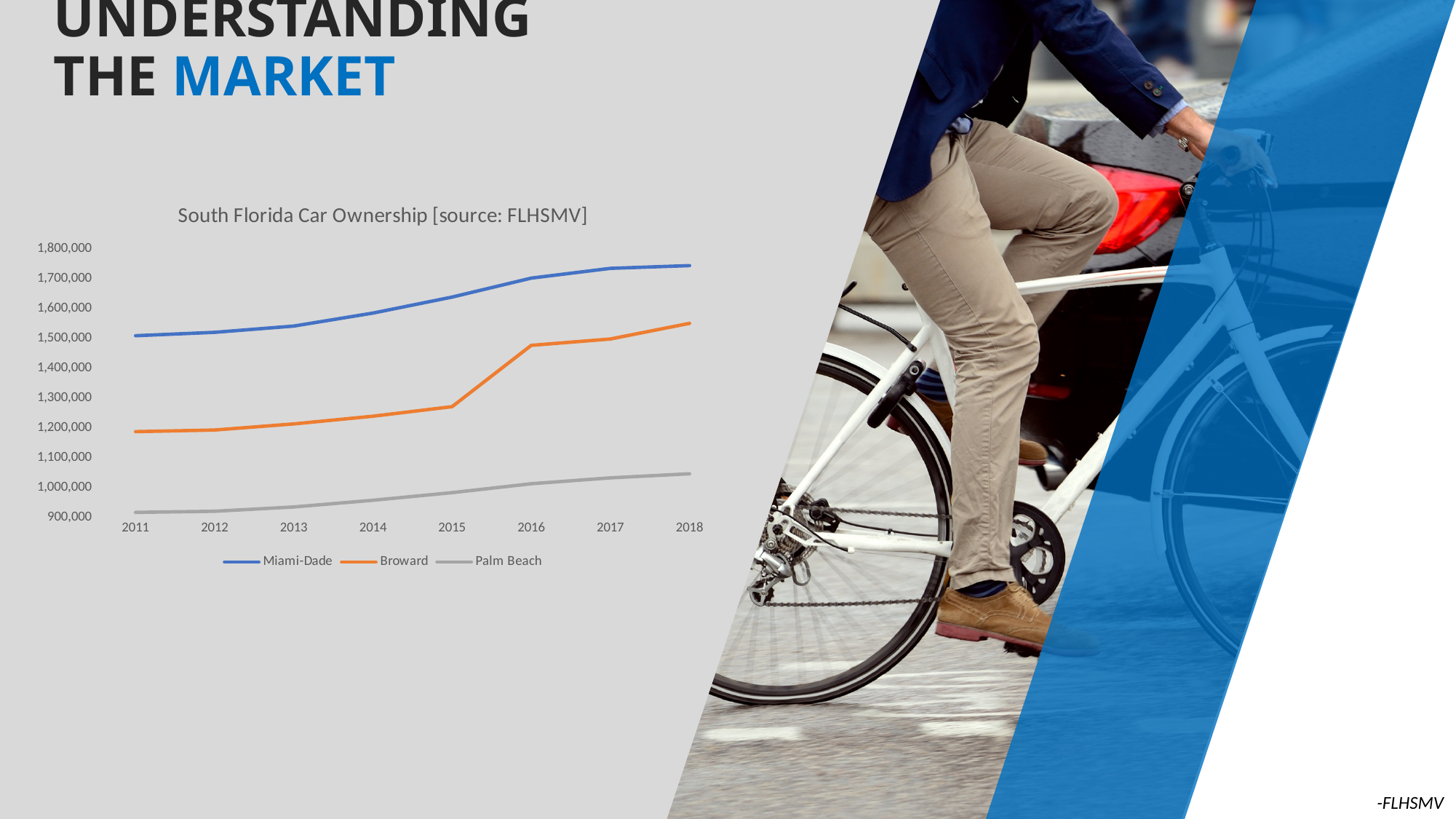
Is the value for Palm Beach in 2011 greater or less than 1,000,000? less What kind of chart is shown on the slide? line chart Does car ownership in Broward rise or fall from 2011 to 2018? rise Which county has the highest car ownership across all years shown? Miami-Dade What is the title of the chart? South Florida Car Ownership [source: FLHSMV] Is the value for Miami-Dade in 2018 greater or less than 1,700,000? greater How many series does the chart's legend list? 3 How many years are plotted along the x axis? 8 Is the value for Broward in 2011 greater or less than 1,200,000? less Which is larger in 2018, the value for Miami-Dade or the value for Broward? Miami-Dade Which county has the lowest car ownership across all years shown? Palm Beach